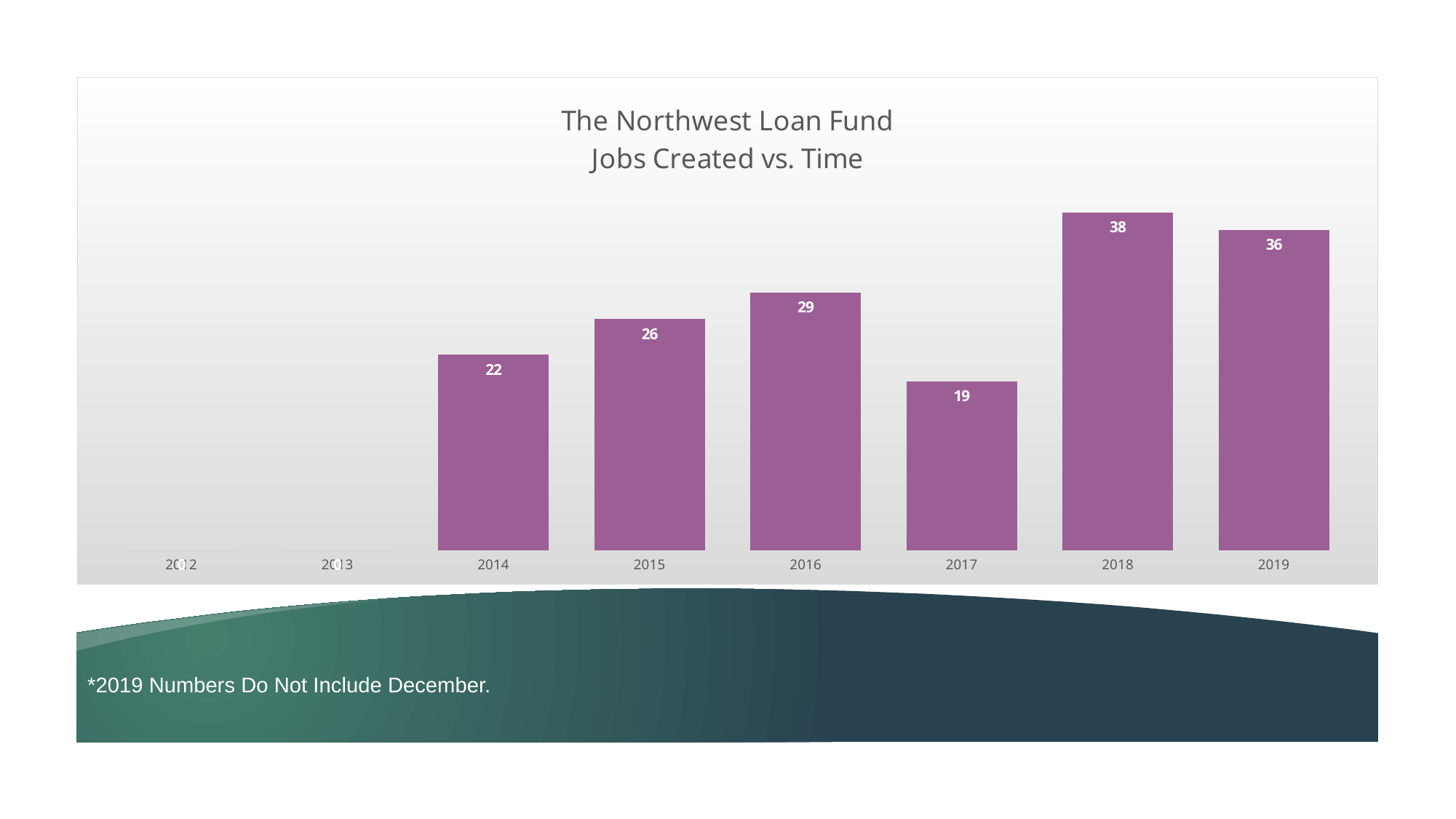
Which year has the highest number of jobs created? 2018 How many years are shown on the x axis? 8 What is the difference between the values for 2016 and 2015? 3 What is the value shown for 2014? 22 How many jobs were created in 2017? 19 How many jobs were created in 2018? 38 Do the values rise or fall from 2014 to 2016? Rise What is the difference between the values for 2018 and 2017? 19 Which year has a larger value, 2019 or 2016? 2019 What is the title of the chart? The Northwest Loan Fund Jobs Created vs. Time Among the years with labelled bars, which year has the lowest number of jobs created? 2017 What kind of chart is shown on the slide? Bar chart